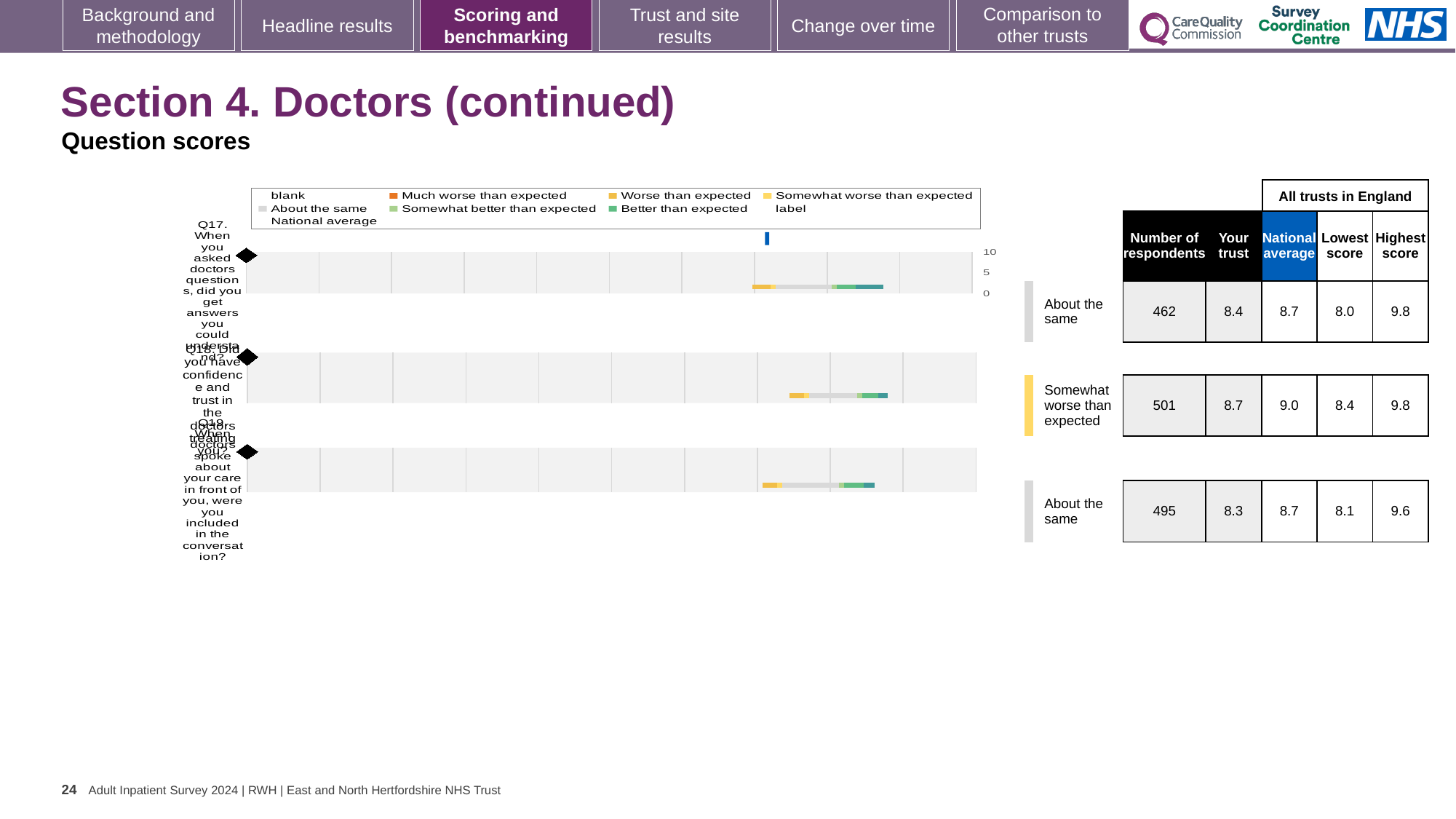
How many respondents answered Q19 (When doctors spoke about your care in front of you, were you included in the conversation)? 495 Which question is rated 'Somewhat worse than expected'? Q18 What is the national average score for Q18 (Did you have confidence and trust in the doctors treating you)? 9.0 How many questions are plotted in the chart? 3 What is the maximum value shown on the chart's score axis? 10 For Q18, what is the difference between the national average and the 'Your trust' score? 0.3 What is the highest score among all trusts in England for Q17? 9.8 What kind of chart is used to show the question scores on this slide? bar chart Which question has the highest 'Your trust' score? Q18 For Q17, which is larger: the 'Your trust' score or the national average? national average What is the 'Your trust' score for Q17 (When you asked doctors questions, did you get answers you could understand)? 8.4 Which question has the lowest 'Your trust' score? Q19